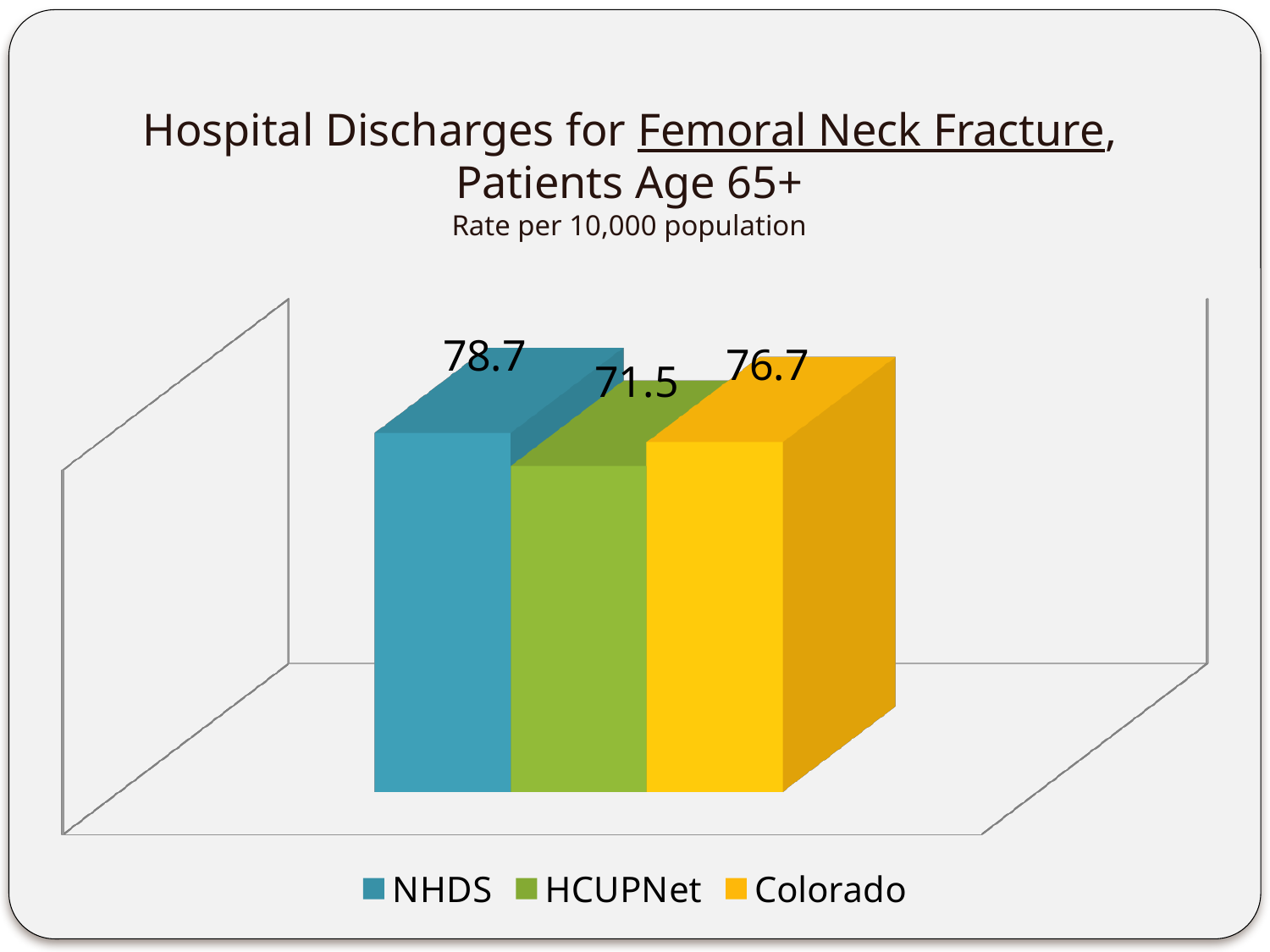
What kind of chart is shown on the slide? Bar chart Which is larger, the value for NHDS or the value for Colorado? NHDS How many bars are plotted on the chart? 3 Which series has the highest value? NHDS What is the difference between the NHDS and HCUPNet values? 7.2 What is the value for NHDS? 78.7 What is the difference between the Colorado and HCUPNet values? 5.2 Which series has the lowest value? HCUPNet What is the value for Colorado? 76.7 What is the value for HCUPNet? 71.5 What unit does the chart subtitle say the values are in? Rate per 10,000 population How many series does the legend list? 3